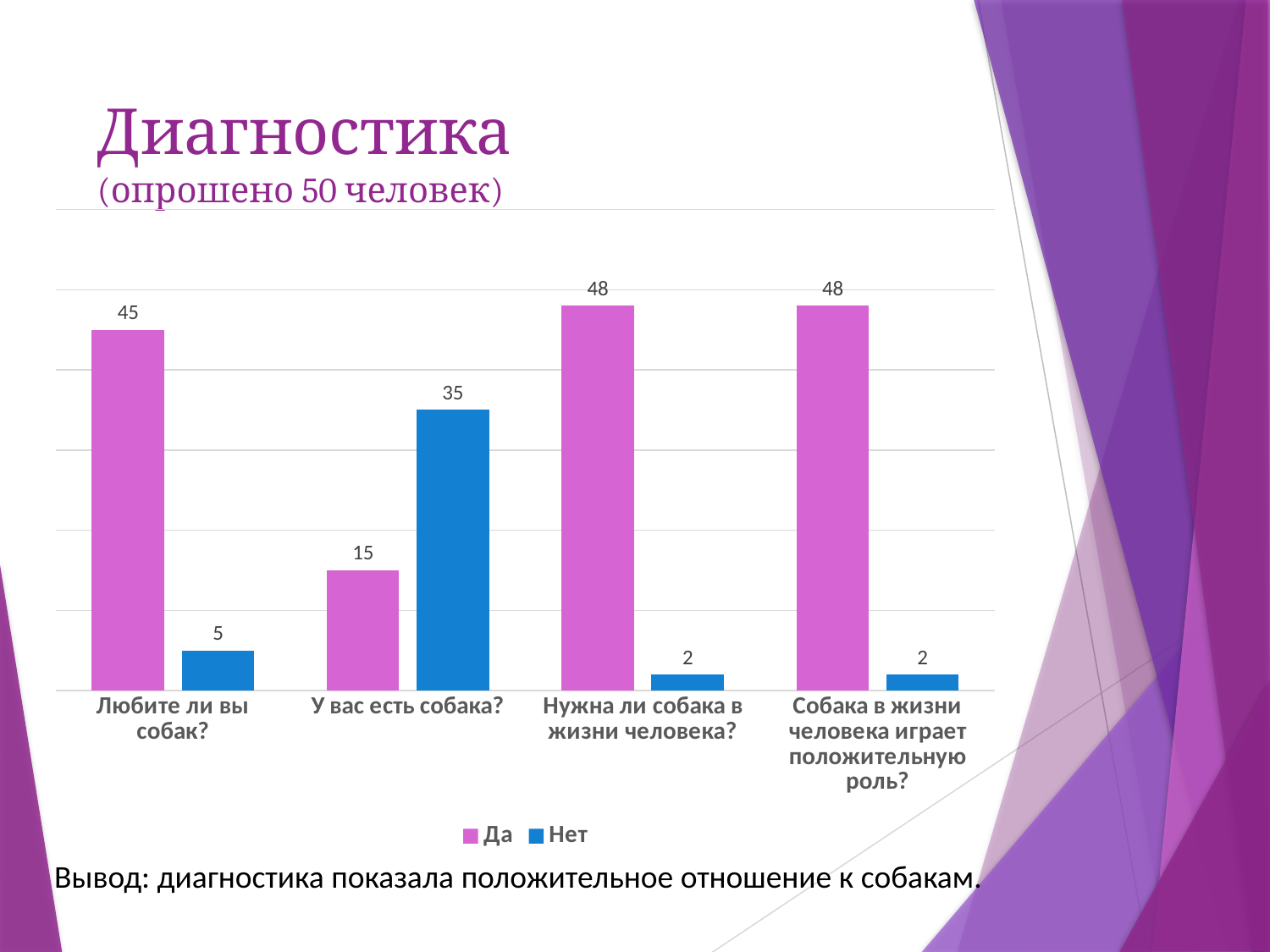
What kind of chart is shown on the slide? Bar chart Which category has the lowest value for "Да"? У вас есть собака? What is the value of "Нет" for "Собака в жизни человека играет положительную роль?"? 2 What is the value of "Да" for "Нужна ли собака в жизни человека?"? 48 What is the difference between "Да" and "Нет" for "Любите ли вы собак?"? 40 For "У вас есть собака?", which is larger, "Да" or "Нет"? Нет What is the difference between "Нет" and "Да" for "У вас есть собака?"? 20 How many series does the legend list? 2 How many categories are shown on the x axis? 4 What is the value of "Нет" for "У вас есть собака?"? 35 What is the value of "Да" for "Любите ли вы собак?"? 45 Which category has the highest value for "Нет"? У вас есть собака?